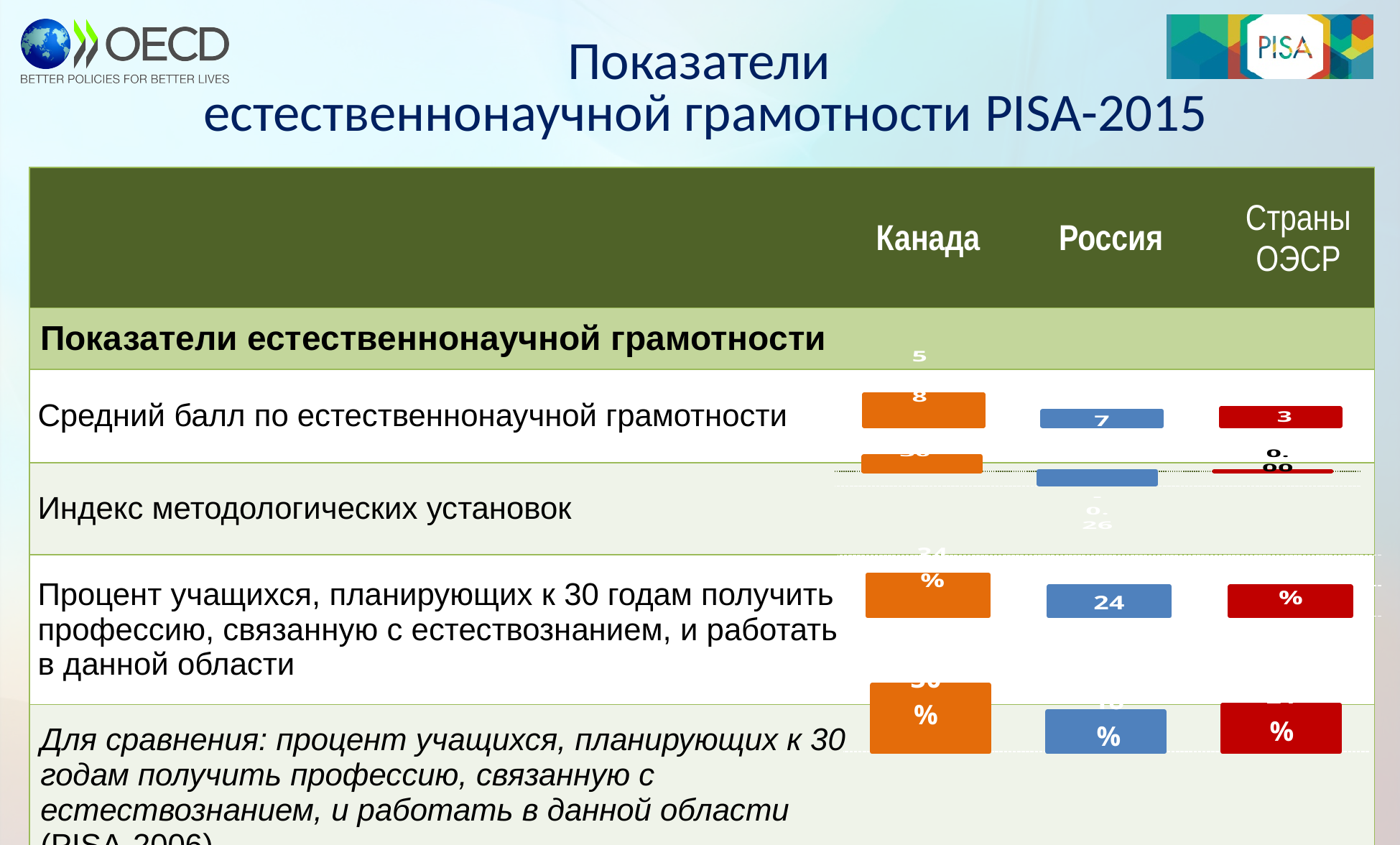
How many countries or groups are compared in the chart columns of the table? 3 What colour are the bars for Россия? blue What kind of chart is used in the table cells to show the values for Канада, Россия and Страны ОЭСР? bar chart What colour are the bars for Канада? orange In the row 'Процент учащихся, планирующих к 30 годам получить профессию, связанную с естествознанием, и работать в данной области', what value is printed on the bar for Россия? 24 Which column of the table is labelled 'Страны ОЭСР'? the rightmost column